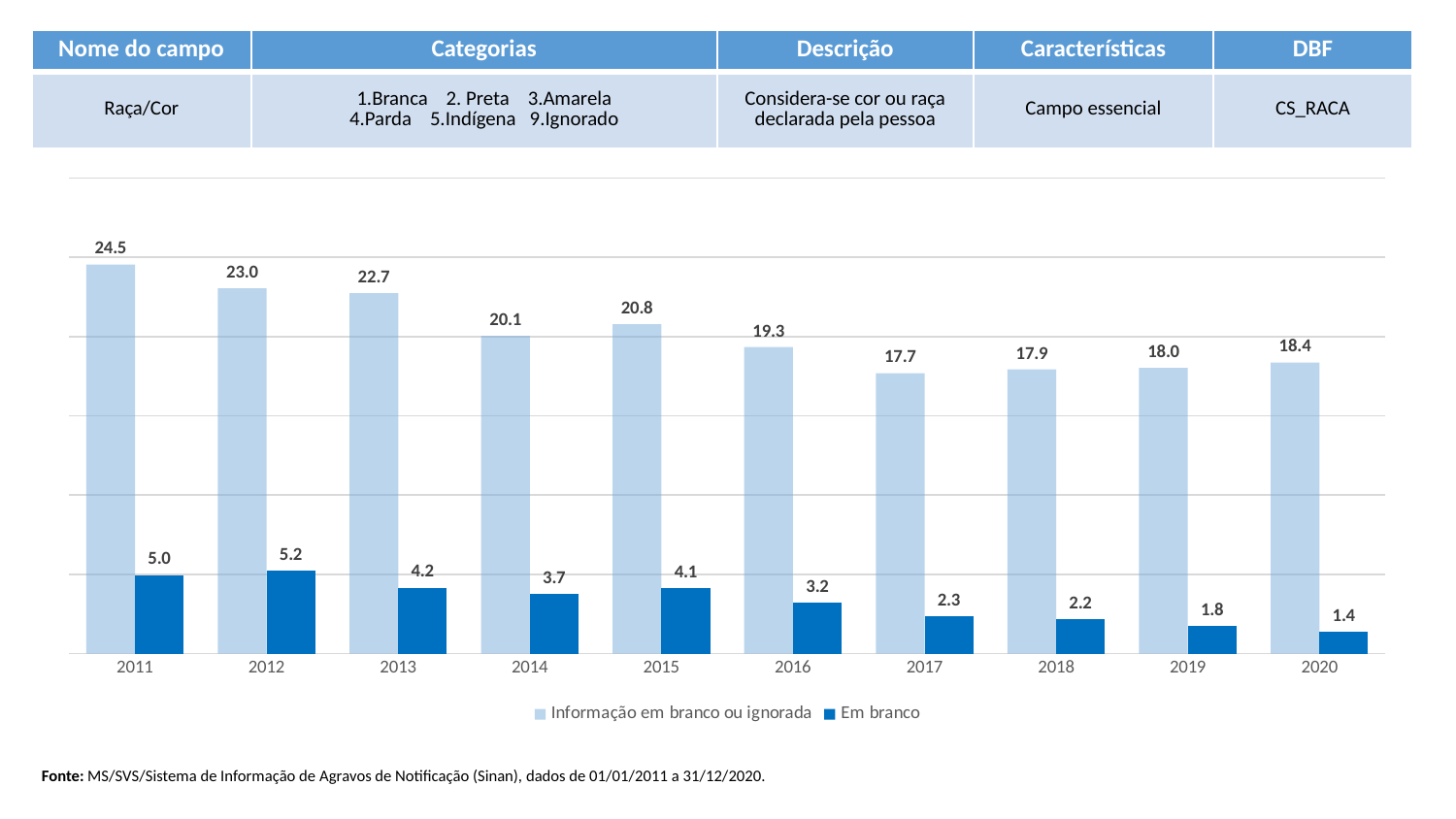
Which is larger: the 'Em branco' value for 2012 or for 2013? 2012 What is the value for 'Em branco' in 2020? 1.4 How many series does the legend list? 2 What is the difference between the 'Informação em branco ou ignorada' values for 2011 and 2020? 6.1 How many years are shown on the x axis? 10 Which year has the highest value for 'Informação em branco ou ignorada'? 2011 What kind of chart is shown on the slide? Bar chart Does the 'Em branco' series generally rise or fall from 2012 to 2020? Fall Which year has the lowest value for 'Em branco'? 2020 What is the value for 'Em branco' in 2015? 4.1 Which year has the lowest value for 'Informação em branco ou ignorada'? 2017 What is the value for 'Informação em branco ou ignorada' in 2011? 24.5